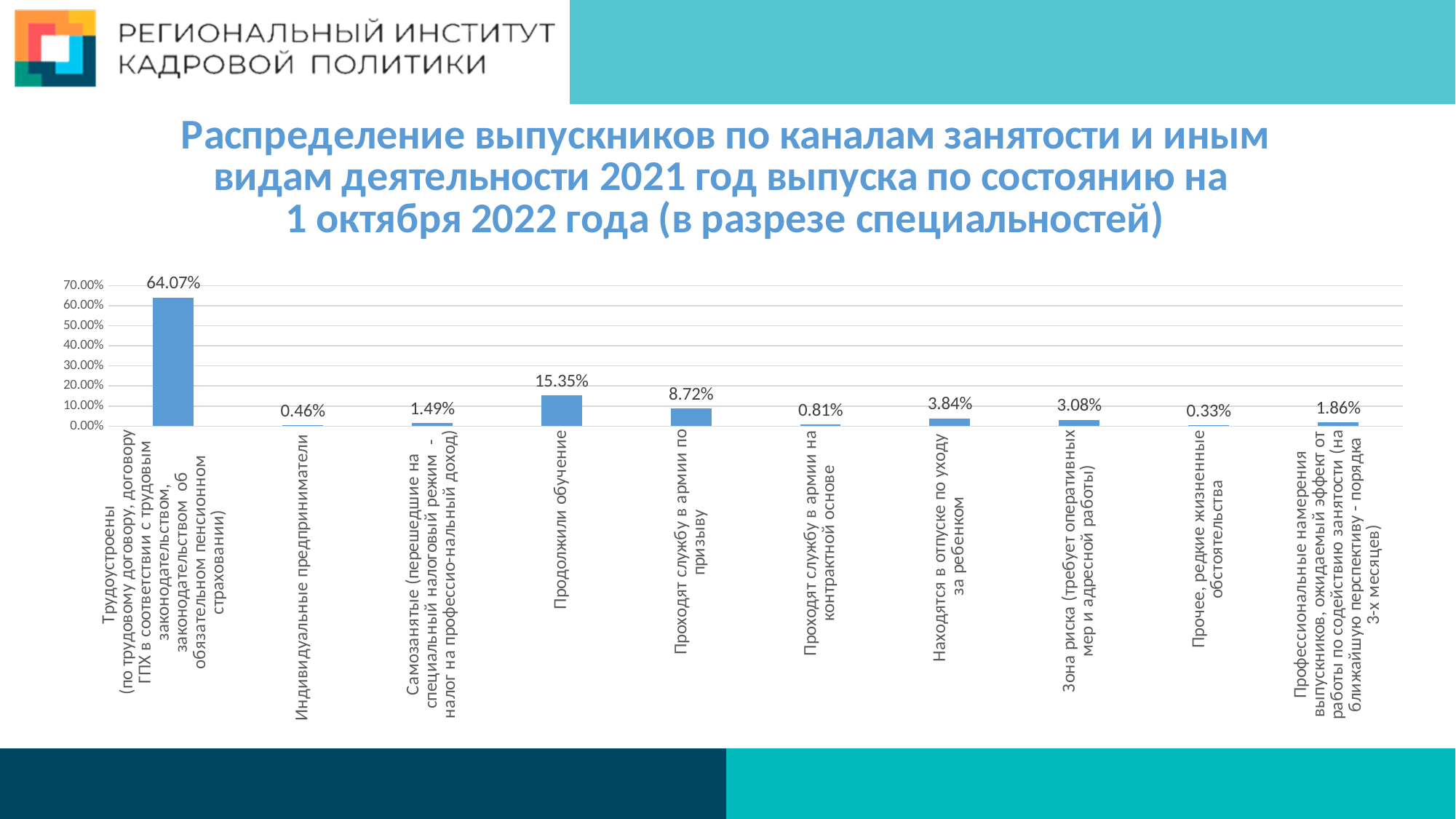
What is the difference between the values for «Трудоустроены» and «Продолжили обучение»? 48.72% What is the value for «Индивидуальные предприниматели»? 0.46% What is the value for «Продолжили обучение»? 15.35% Which is larger: the value for «Зона риска» or the value for «Находятся в отпуске по уходу за ребенком»? Находятся в отпуске по уходу за ребенком What is the value for «Находятся в отпуске по уходу за ребенком»? 3.84% Which category has the highest value? Трудоустроены How many categories are shown in the chart? 10 What kind of chart is shown on the slide? Bar chart Is the value for «Трудоустроены» greater or less than 60.00%? greater What is the value for «Проходят службу в армии по призыву»? 8.72% Which category has the lowest value? Прочее, редкие жизненные обстоятельства What is the difference between the values for «Продолжили обучение» and «Проходят службу в армии по призыву»? 6.63%